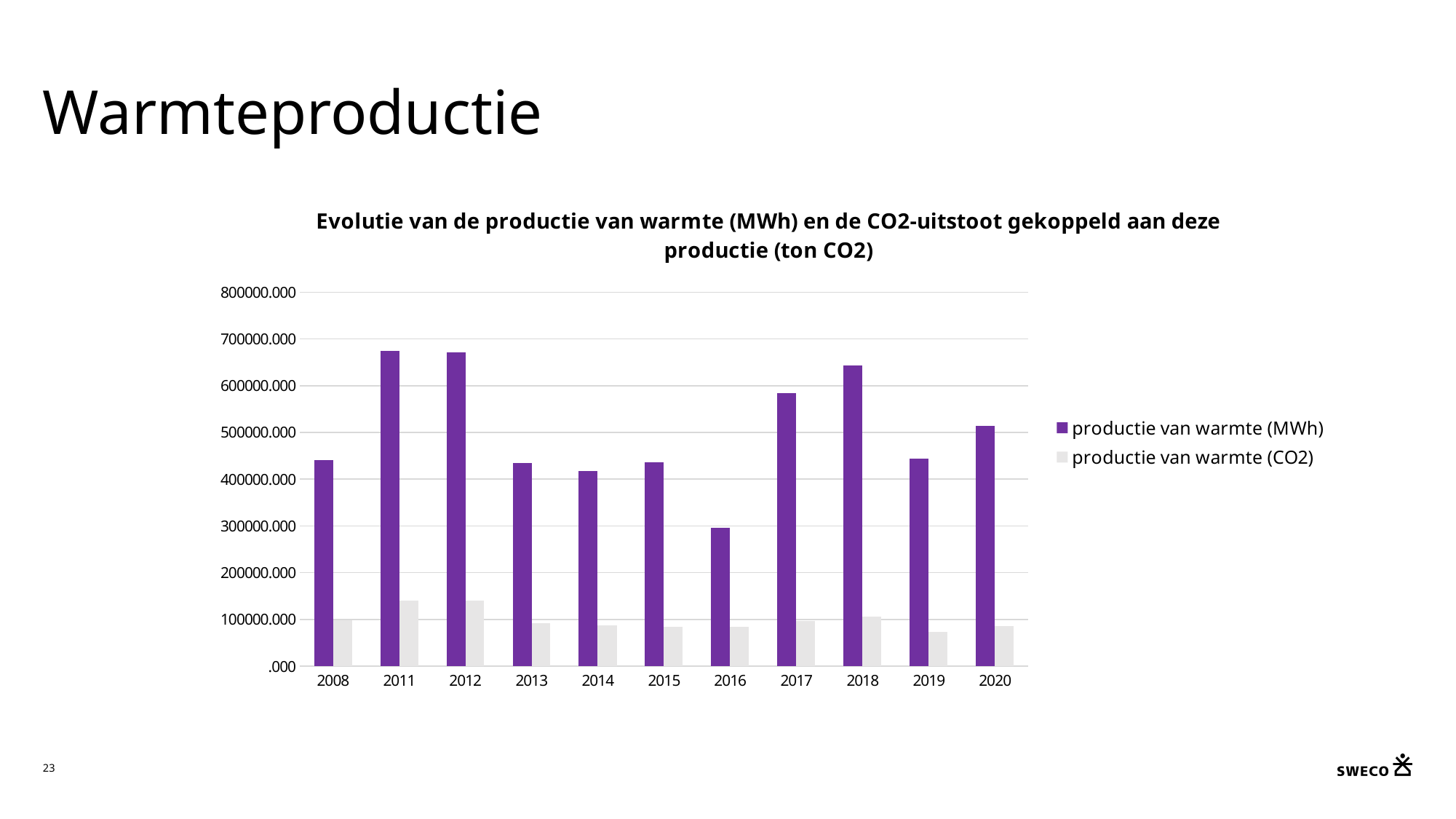
Is the value for productie van warmte (MWh) in 2017 greater or less than 500000.000? greater Which is larger, productie van warmte (MWh) in 2008 or in 2011? 2011 Which year has the lowest value for productie van warmte (CO2)? 2019 Is the value for productie van warmte (MWh) in 2018 greater or less than 600000.000? greater What kind of chart is shown on the slide? bar chart Which series is shown in purple? productie van warmte (MWh) How many series does the legend list? 2 Is the value for productie van warmte (MWh) in 2016 greater or less than 400000.000? less How many years are shown on the x axis? 11 Which year has the lowest value for productie van warmte (MWh)? 2016 Which is larger, productie van warmte (MWh) in 2017 or in 2018? 2018